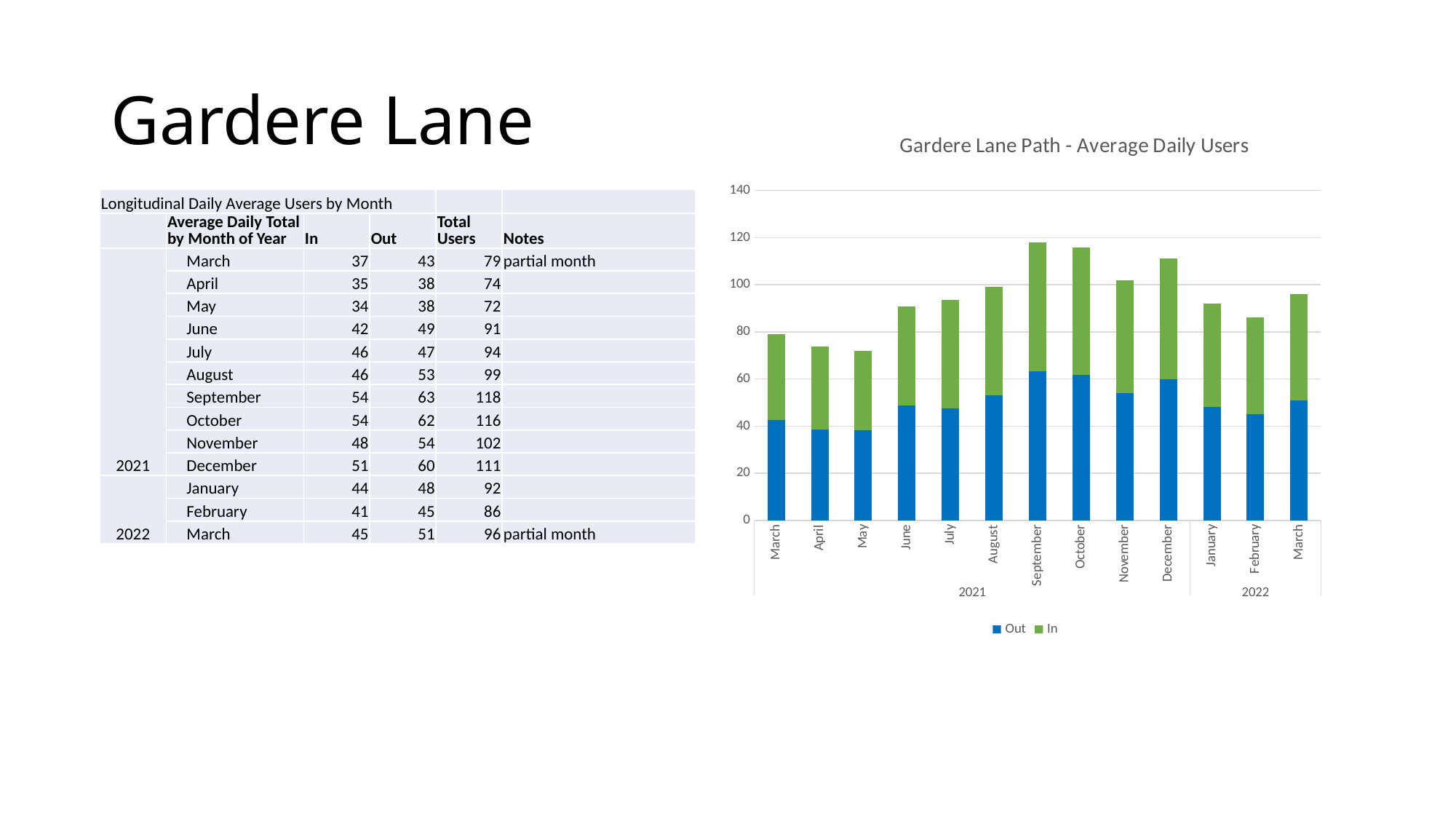
What kind of chart is shown on the slide? stacked bar chart Which colour represents the Out series in the chart? blue Which bar is taller, April 2021 or August 2021? August 2021 What is the title of the chart? Gardere Lane Path - Average Daily Users How many monthly bars are plotted in the chart? 13 How many series does the chart legend list? 2 What is the total average daily users for September 2021? 118 Is the total bar for September 2021 greater or less than 100? greater Which bar is taller, September 2021 or February 2022? September 2021 Is the total bar for May 2021 greater or less than 80? less Is the total bar for February 2022 greater or less than 100? less Do the total bars generally rise or fall from May 2021 to September 2021? rise